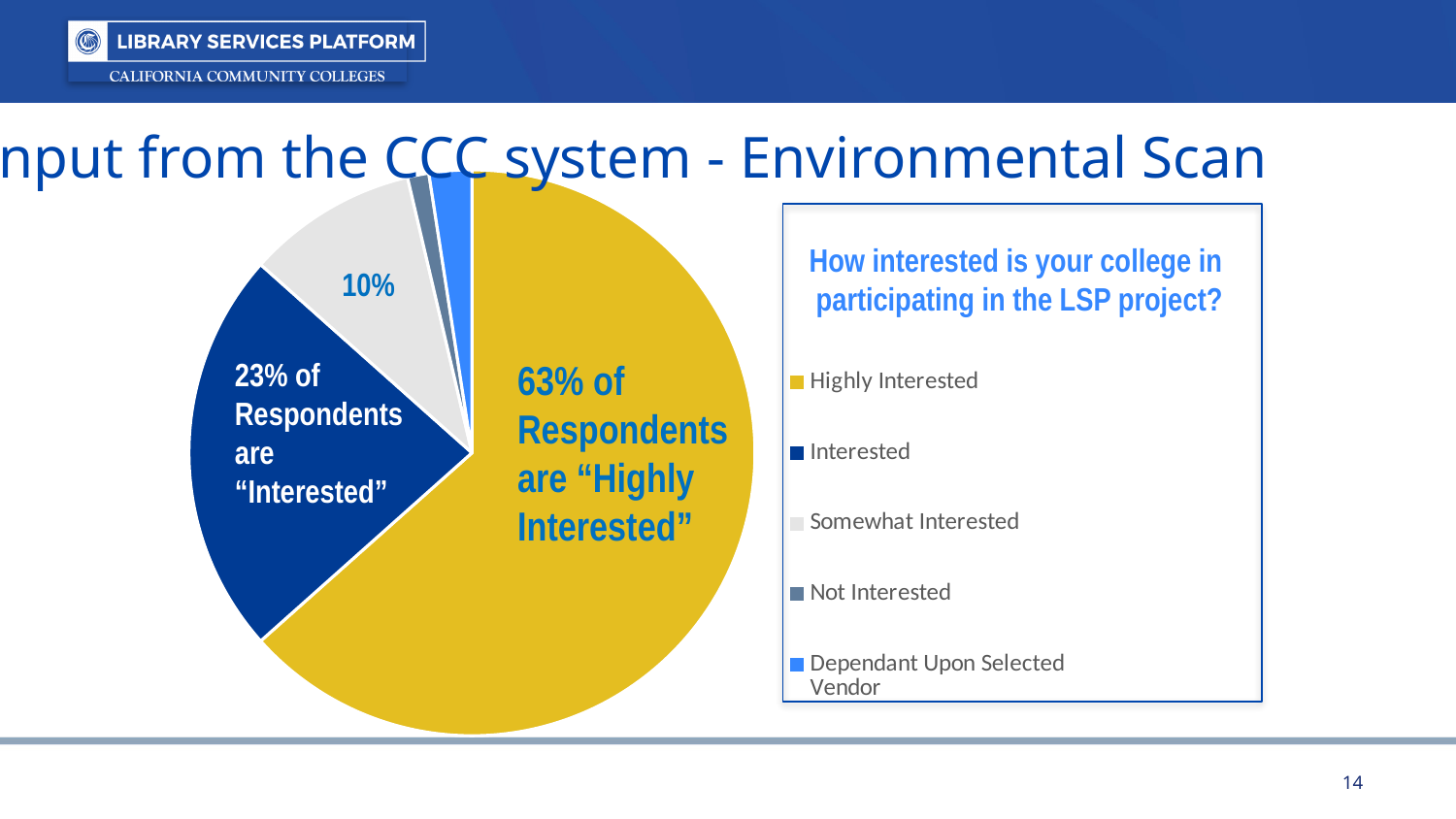
What percentage of respondents are "Highly Interested"? 63% Which is larger: the share of "Interested" respondents or the share of "Somewhat Interested" respondents? Interested What percentage of respondents are "Somewhat Interested"? 10% What percentage of respondents are "Interested"? 23% How many response categories does the legend list? 5 Which response category has the largest share of the pie? Highly Interested What question is the pie chart answering, according to its title? How interested is your college in participating in the LSP project? How many percentage points larger is the "Highly Interested" share than the "Interested" share? 40 percentage points What kind of chart is shown on the slide? Pie chart Which response category has the smallest share of the pie? Not Interested How many percentage points larger is the "Interested" share than the "Somewhat Interested" share? 13 percentage points What colour represents "Highly Interested" in the pie chart? Yellow